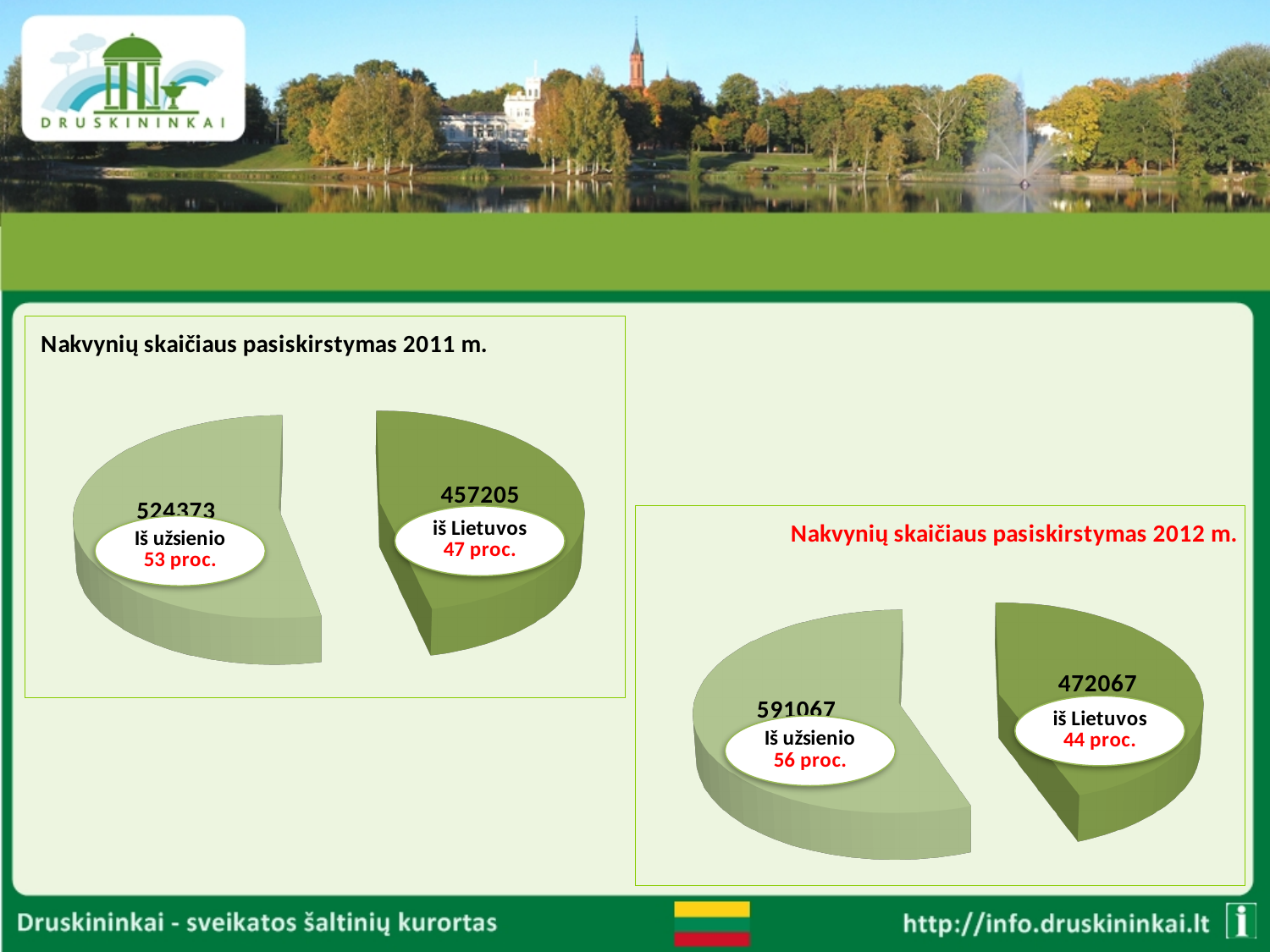
In the 2012 chart, what is the value for 'iš Lietuvos'? 472067 In the 2011 chart, what share of the pie does 'Iš užsienio' have? 53 proc. In the 2012 chart, which category is the smallest? iš Lietuvos In the 2011 chart, what is the value for 'iš Lietuvos'? 457205 In the 2012 chart, what is the difference between 'Iš užsienio' and 'iš Lietuvos'? 119000 In the 2012 chart, what share of the pie does 'iš Lietuvos' have? 44 proc. How many slices does the 2012 pie chart have? 2 In the 2012 chart, what is the value for 'Iš užsienio'? 591067 In the 2011 chart, what is the difference between 'Iš užsienio' and 'iš Lietuvos'? 67168 In the 2011 chart, which category is the largest? Iš užsienio What kind of chart is used in 'Nakvynių skaičiaus pasiskirstymas 2011 m.'? pie chart In the 2011 chart, what is the value for 'Iš užsienio'? 524373